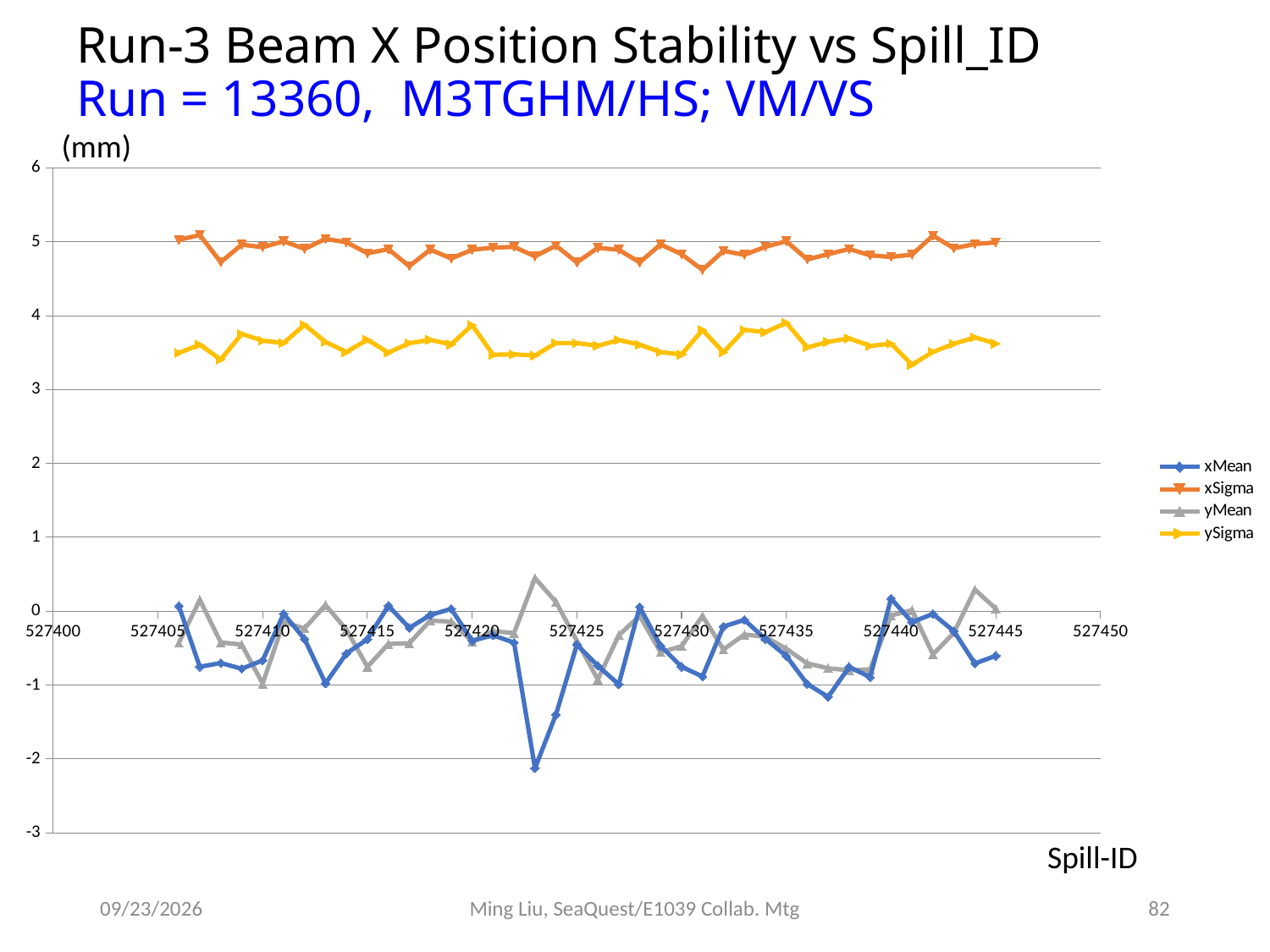
Are the ySigma values greater or less than 3? greater Are the xSigma values greater or less than 4? greater How many series does the legend list? 4 Which series has the highest values across the chart? xSigma Is the highest yMean value greater or less than 1? less What are the series names listed in the legend? xMean, xSigma, yMean, ySigma Which series reaches the lowest value on the chart? xMean Which series is larger, xSigma or ySigma? xSigma What kind of chart is shown on the slide? line chart What is the label of the x axis? Spill-ID